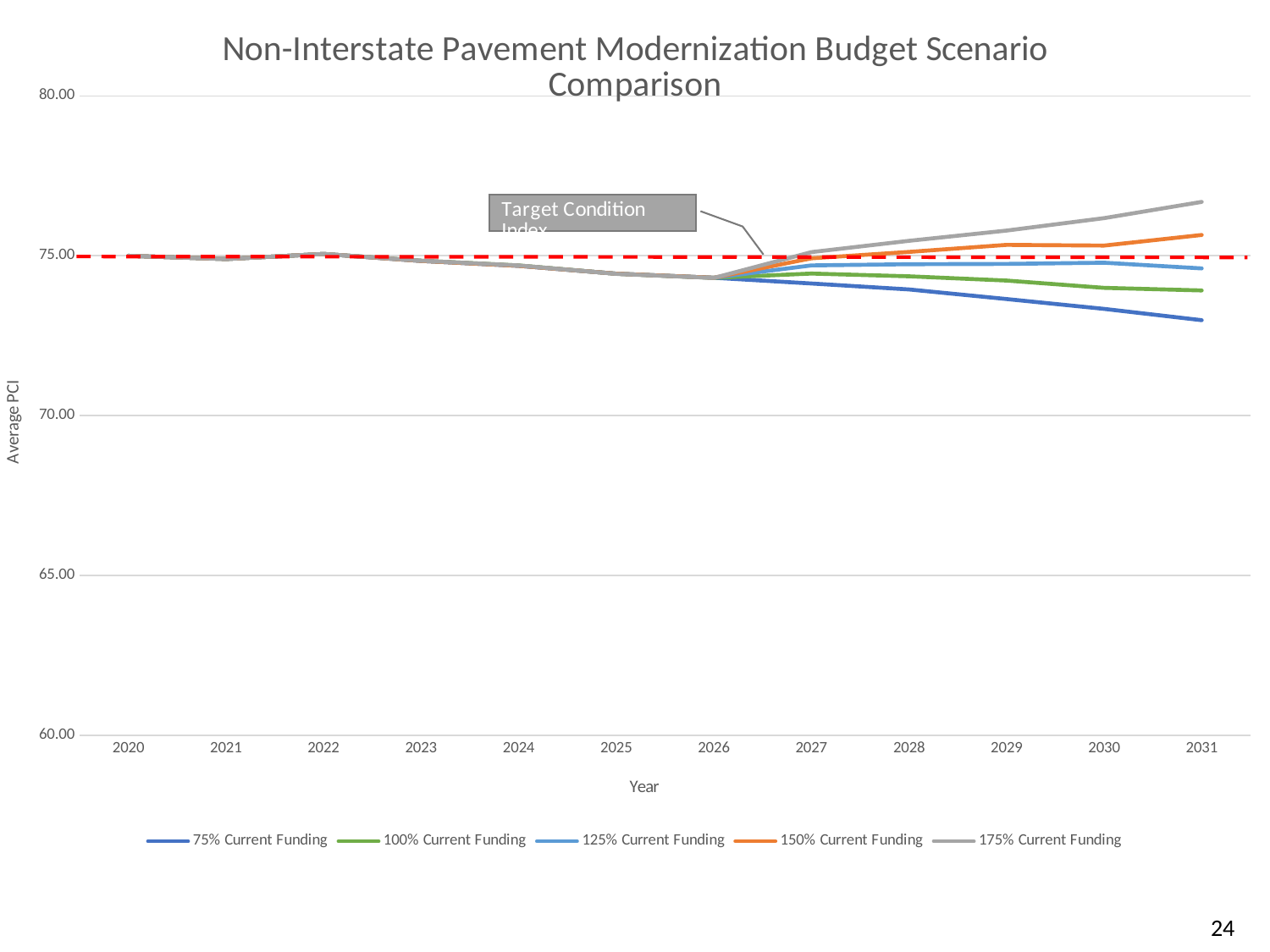
What kind of chart is shown on the slide? Line chart What does the red dashed horizontal line represent? Target Condition Index Which funding scenario has the lowest Average PCI in 2031? 75% Current Funding Is the Average PCI for 75% Current Funding in 2031 greater or less than 75.00? less Does the Average PCI for 175% Current Funding rise or fall from 2026 to 2031? rise In 2031, which is higher: 150% Current Funding or 100% Current Funding? 150% Current Funding Is the Average PCI for 175% Current Funding in 2031 greater or less than 75.00? greater How many series does the legend list? 5 Is the Average PCI for 100% Current Funding in 2031 greater or less than 75.00? less How many years are shown along the x axis? 12 Which funding scenario has the highest Average PCI in 2031? 175% Current Funding Does the Average PCI for 75% Current Funding rise or fall from 2026 to 2031? fall